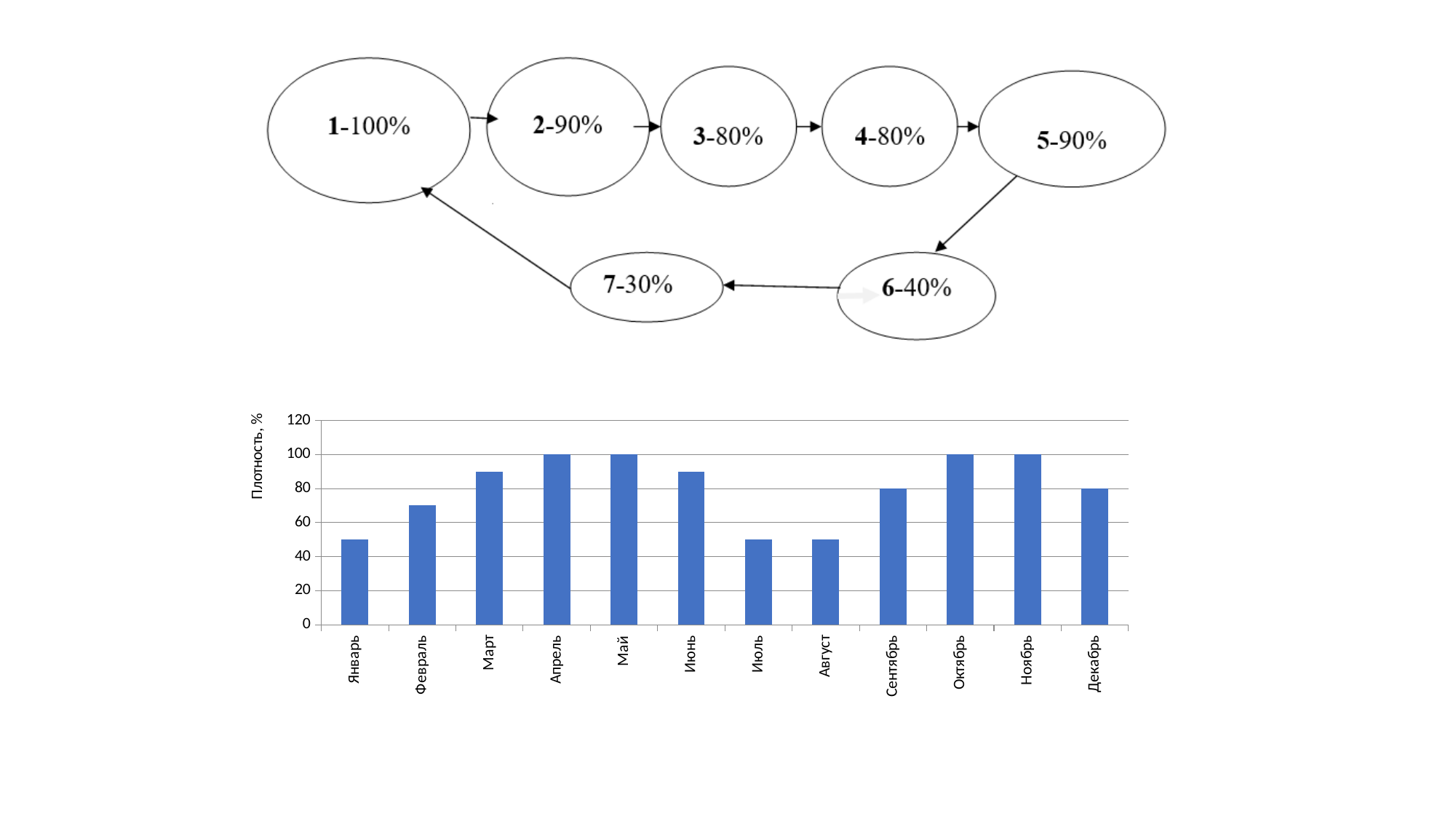
In the bar chart, what is the difference between the values for Апрель and Сентябрь? 20 Is the value for Март in the bar chart greater or less than 80? greater What is the value for Сентябрь in the bar chart? 80 Is the value for Январь in the bar chart greater or less than 60? less Is the value for Февраль in the bar chart greater or less than 60? greater What is the value for Апрель in the bar chart? 100 How many months (categories) are shown on the x axis of the bar chart? 12 What is the title of the vertical axis of the bar chart? Плотность, % What is the value for Ноябрь in the bar chart? 100 What type of chart is shown at the bottom of the slide? bar chart In the bar chart, which is larger: the value for Март or the value for Июль? Март What is the value for Декабрь in the bar chart? 80